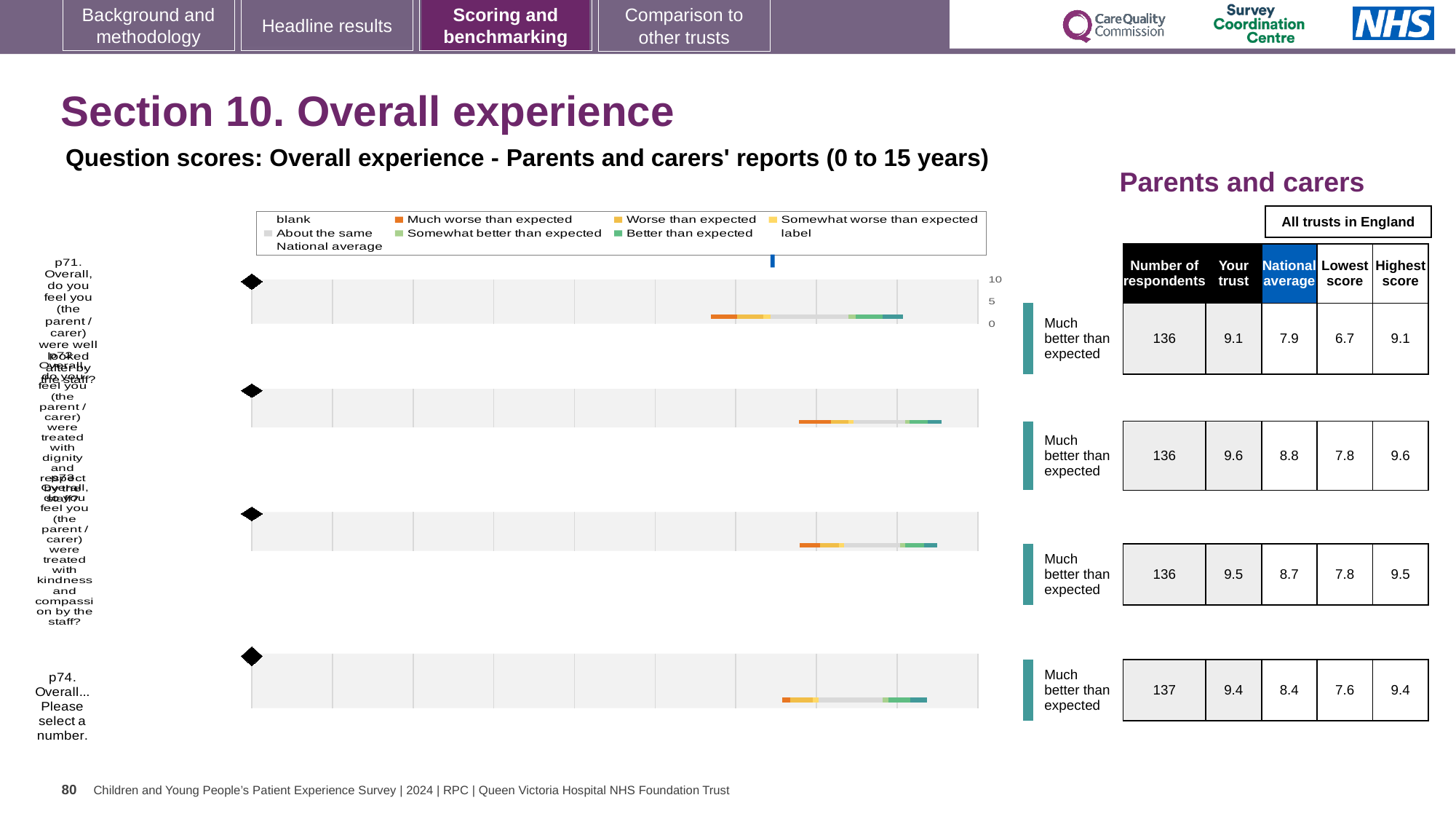
What is the difference between the 'Your trust' score and the national average for p71? 1.2 What benchmark rating is shown next to the chart row for p71 (well looked after by the staff)? Much better than expected Which question has the lowest national average score? p74 What is the 'Your trust' score for p71 (well looked after by the staff)? 9.1 Which question has the highest 'Your trust' score? p72 What kind of chart is used to show the question scores on this slide? bar chart Which has the higher 'Your trust' score, p72 or p74? p72 What is the title of the chart on this slide? Question scores: Overall experience - Parents and carers' reports (0 to 15 years) What is the national average score for p72 (treated with dignity and respect)? 8.8 How many questions (rows) are plotted in the chart? 4 How many respondents answered p74 (Overall... Please select a number)? 137 What is the lowest score across all trusts in England for p73 (treated with kindness and compassion)? 7.8